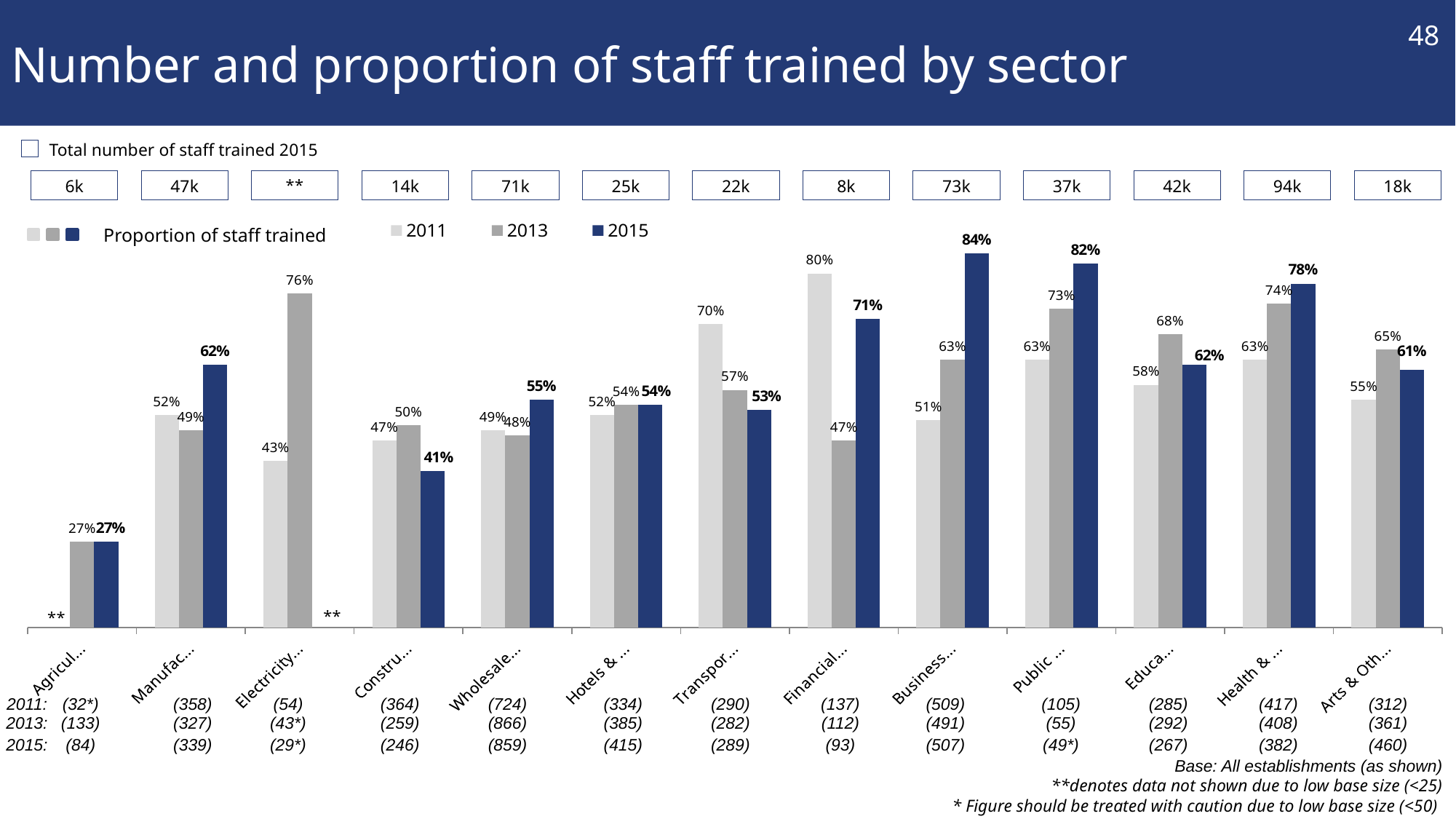
What is the difference between the 2011 and 2013 proportions of staff trained for the Financial... sector? 33 percentage points Does the proportion of staff trained for the Public... sector rise or fall from 2011 to 2015? Rise Which sector has the highest 2011 proportion of staff trained? Financial... For the Transpor... sector, which year has the larger proportion of staff trained, 2011 or 2015? 2011 What kind of chart is used to show the proportion of staff trained? Bar chart What is the 2015 proportion of staff trained for the Business... sector? 84% How many series does the legend of the proportion chart list? 3 What is the 2013 proportion of staff trained for the Electricity... sector? 76% What is the total number of staff trained in 2015 for the Health &... sector? 94k How many sectors are shown on the x axis of the chart? 13 Which sector has the highest 2015 proportion of staff trained? Business... Which sector has the lowest 2015 proportion of staff trained? Agricul...